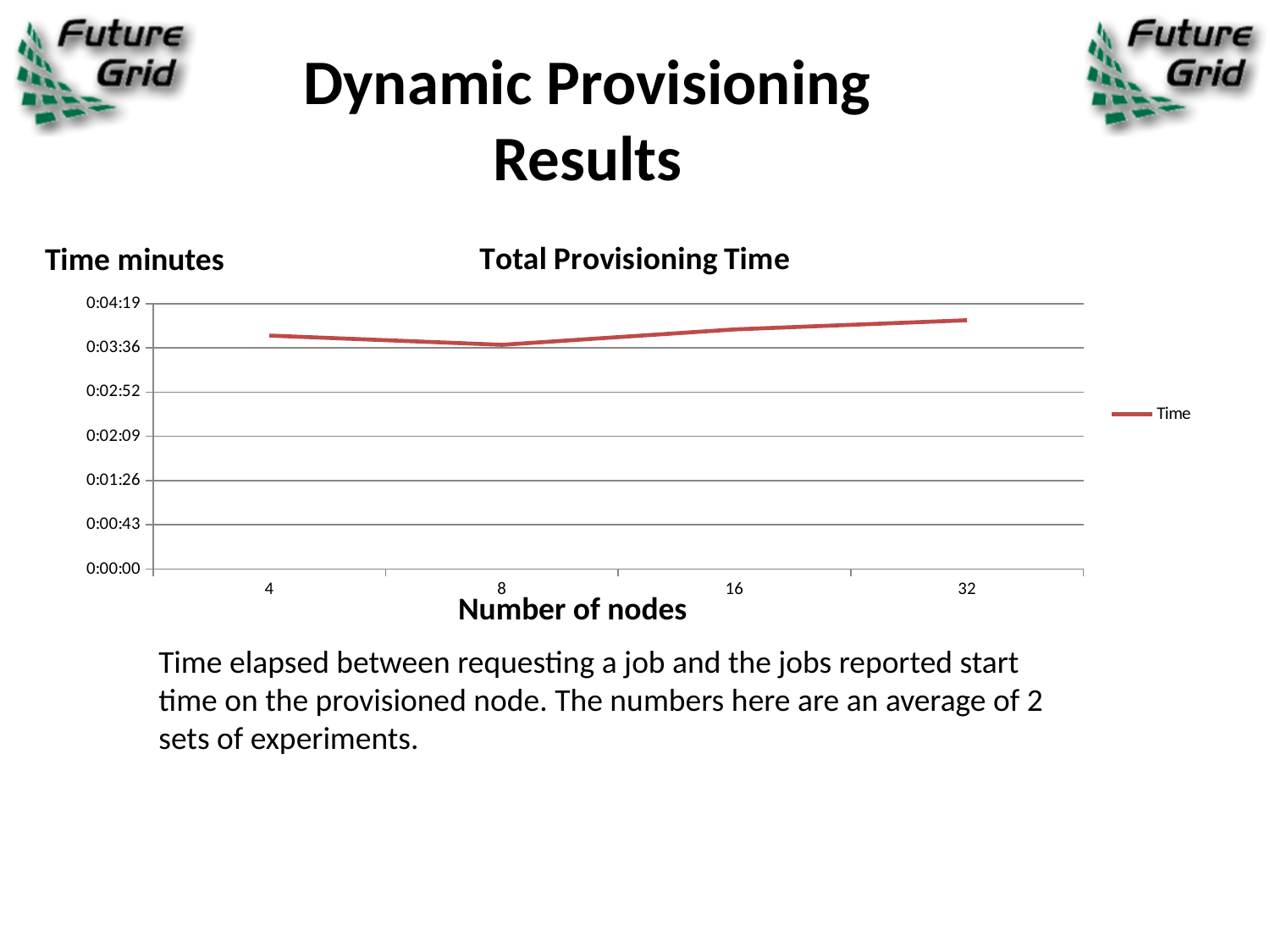
Is the provisioning time for 8 nodes greater or less than 0:02:52? greater Which has a larger provisioning time, 16 nodes or 8 nodes? 16 nodes What type of chart is shown on the slide? line chart What is the name of the series shown in the legend? Time Is the provisioning time for 32 nodes greater or less than 0:03:36? greater Which has a larger provisioning time, 32 nodes or 8 nodes? 32 nodes How many series does the legend list? 1 Which number of nodes has the lowest total provisioning time? 8 Does the provisioning time rise or fall from 8 nodes to 32 nodes? rise Which number of nodes has the highest total provisioning time? 32 How many node counts are plotted along the x axis? 4 What is the title of the chart? Total Provisioning Time